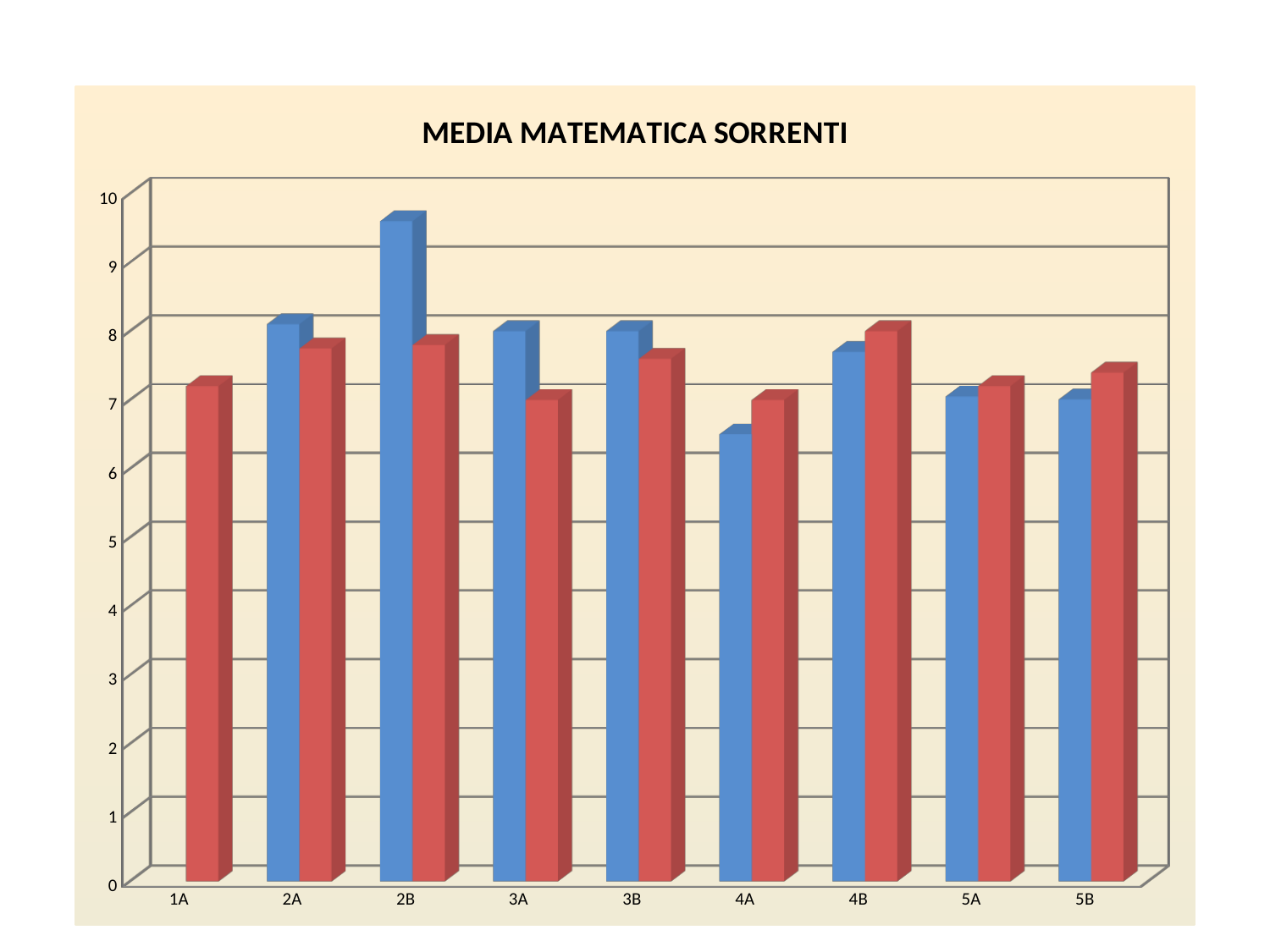
For category 4A, which bar is taller, the blue one or the red one? red For category 2B, which bar is taller, the blue one or the red one? blue Which category has only a red bar and no blue bar? 1A Which category has the highest blue bar? 2B Which category has the lowest blue bar? 4A Is the blue bar for 2B greater or less than 9? greater What is the title of the chart? MEDIA MATEMATICA SORRENTI How many categories are shown on the x axis? 9 Is the red bar for 5B greater or less than 7? greater What kind of chart is shown on the slide? bar chart Is the blue bar for 4A greater or less than 7? less